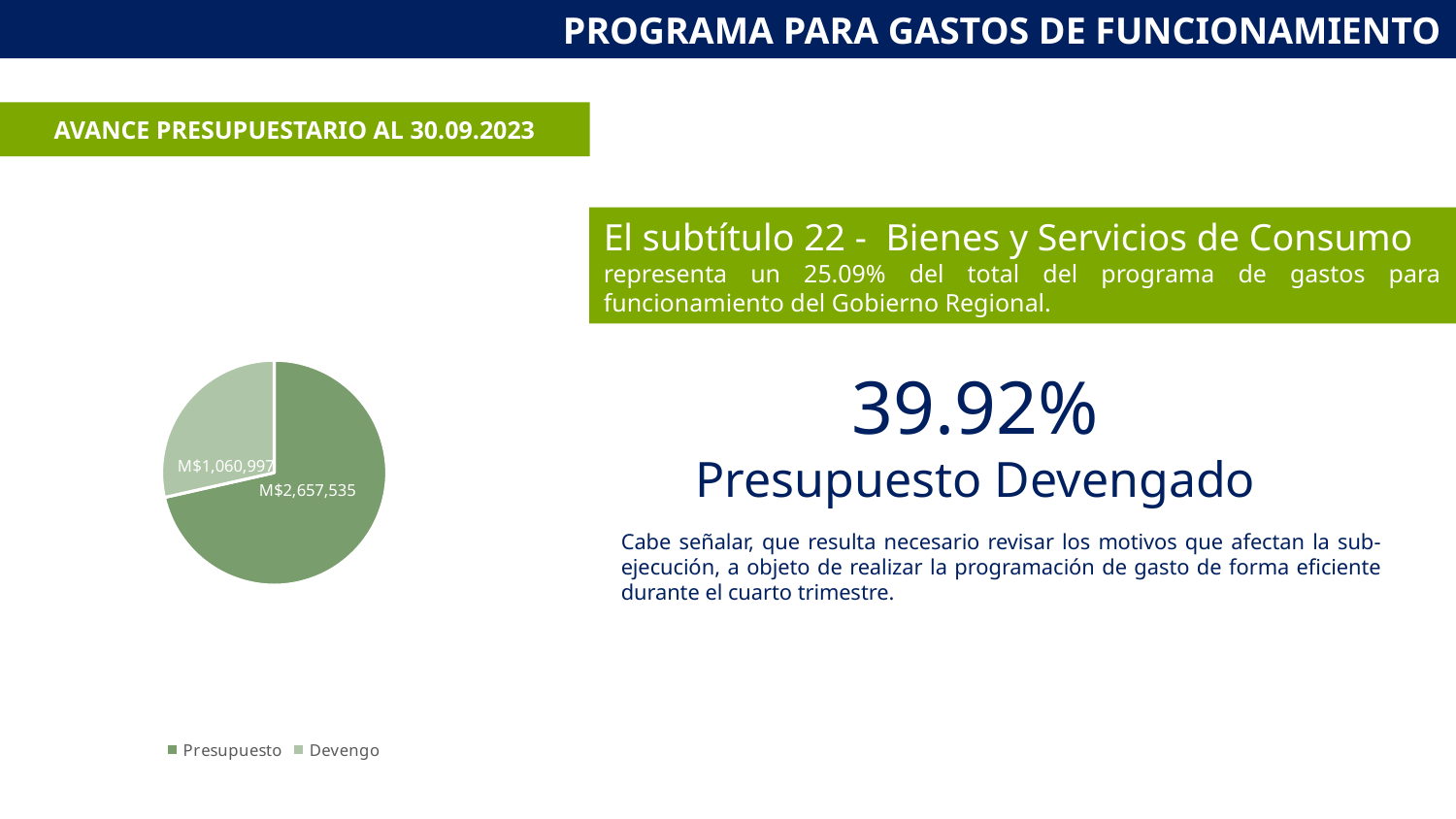
Which slice of the pie chart is the smallest? Devengo How many slices does the pie chart have? 2 Which is larger in the pie chart, Presupuesto or Devengo? Presupuesto What are the two legend entries of the pie chart? Presupuesto and Devengo How many entries does the legend of the pie chart list? 2 What is the difference between the Presupuesto and Devengo values shown in the pie chart? M$1,596,538 Which legend entry of the pie chart is shown in the lighter green colour? Devengo What is the value of the Devengo slice in the pie chart? M$1,060,997 What type of chart is shown on the slide? Pie chart Which slice of the pie chart is the largest? Presupuesto What is the value of the Presupuesto slice in the pie chart? M$2,657,535